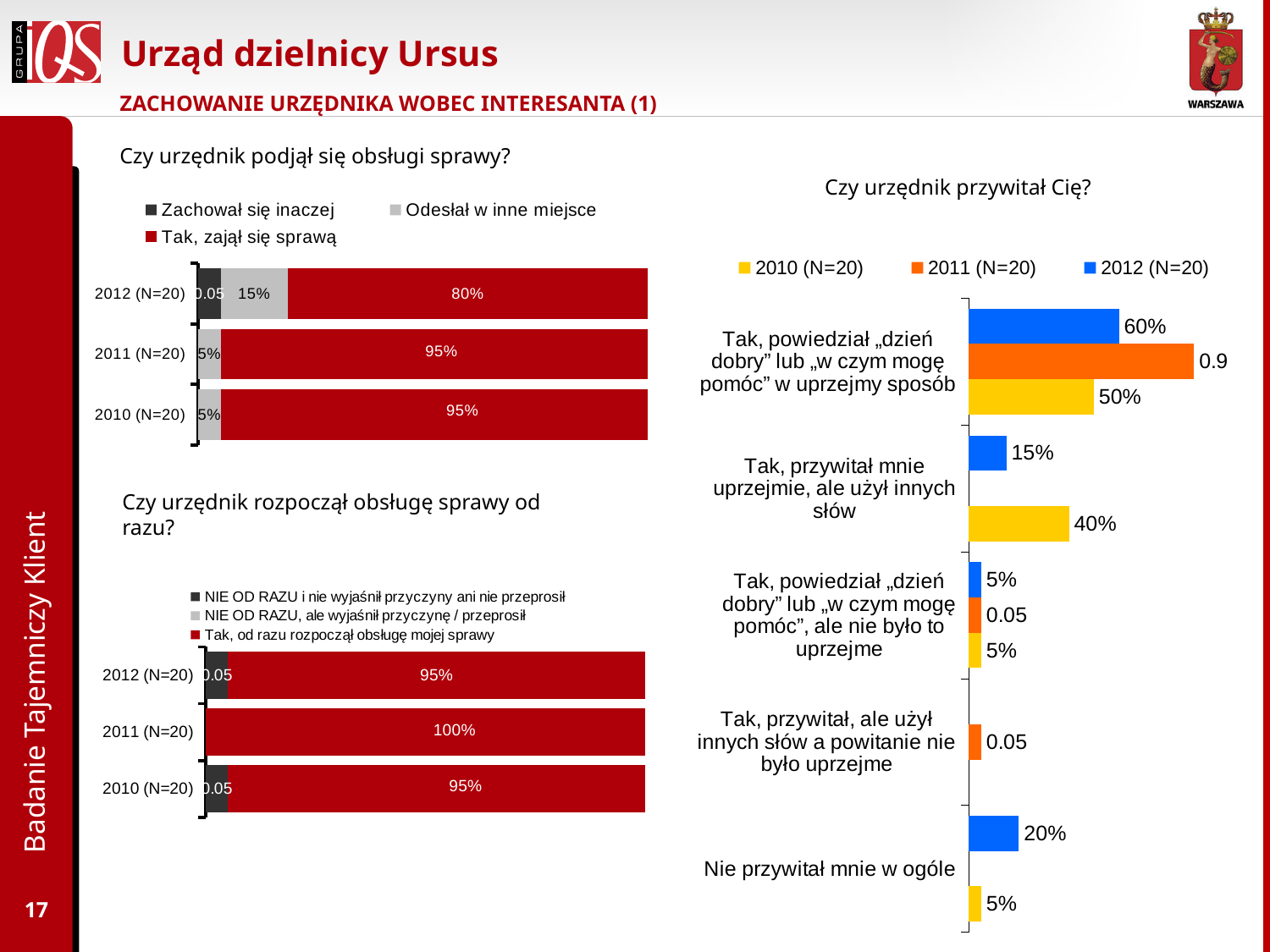
In the chart "Czy urzędnik podjął się obsługi sprawy?", which year has the lowest "Tak, zajął się sprawą" value? 2012 (N=20) In the chart "Czy urzędnik przywitał Cię?", which is larger for "Nie przywitał mnie w ogóle": the 2012 (N=20) value or the 2010 (N=20) value? 2012 (N=20) In the chart "Czy urzędnik przywitał Cię?", what is the difference between the 2010 (N=20) and 2012 (N=20) values for "Tak, przywitał mnie uprzejmie, ale użył innych słów"? 25% In the chart "Czy urzędnik podjął się obsługi sprawy?", what is the "Odesłał w inne miejsce" value for 2012 (N=20)? 15% In the chart "Czy urzędnik podjął się obsługi sprawy?", what is the "Tak, zajął się sprawą" value for 2012 (N=20)? 80% In the chart "Czy urzędnik przywitał Cię?", what is the 2010 (N=20) value for "Tak, przywitał mnie uprzejmie, ale użył innych słów"? 40% What type of chart is "Czy urzędnik rozpoczął obsługę sprawy od razu?"? Stacked bar chart In the chart "Czy urzędnik przywitał Cię?", what is the 2012 (N=20) value for "Tak, powiedział „dzień dobry” lub „w czym mogę pomóc” w uprzejmy sposób"? 60% In the chart "Czy urzędnik przywitał Cię?", what is the 2012 (N=20) value for "Nie przywitał mnie w ogóle"? 20% In the chart "Czy urzędnik przywitał Cię?", how many series does the legend list? 3 In the chart "Czy urzędnik rozpoczął obsługę sprawy od razu?", what is the "Tak, od razu rozpoczął obsługę mojej sprawy" value for 2011 (N=20)? 100% In the chart "Czy urzędnik przywitał Cię?", how many answer categories are shown? 5